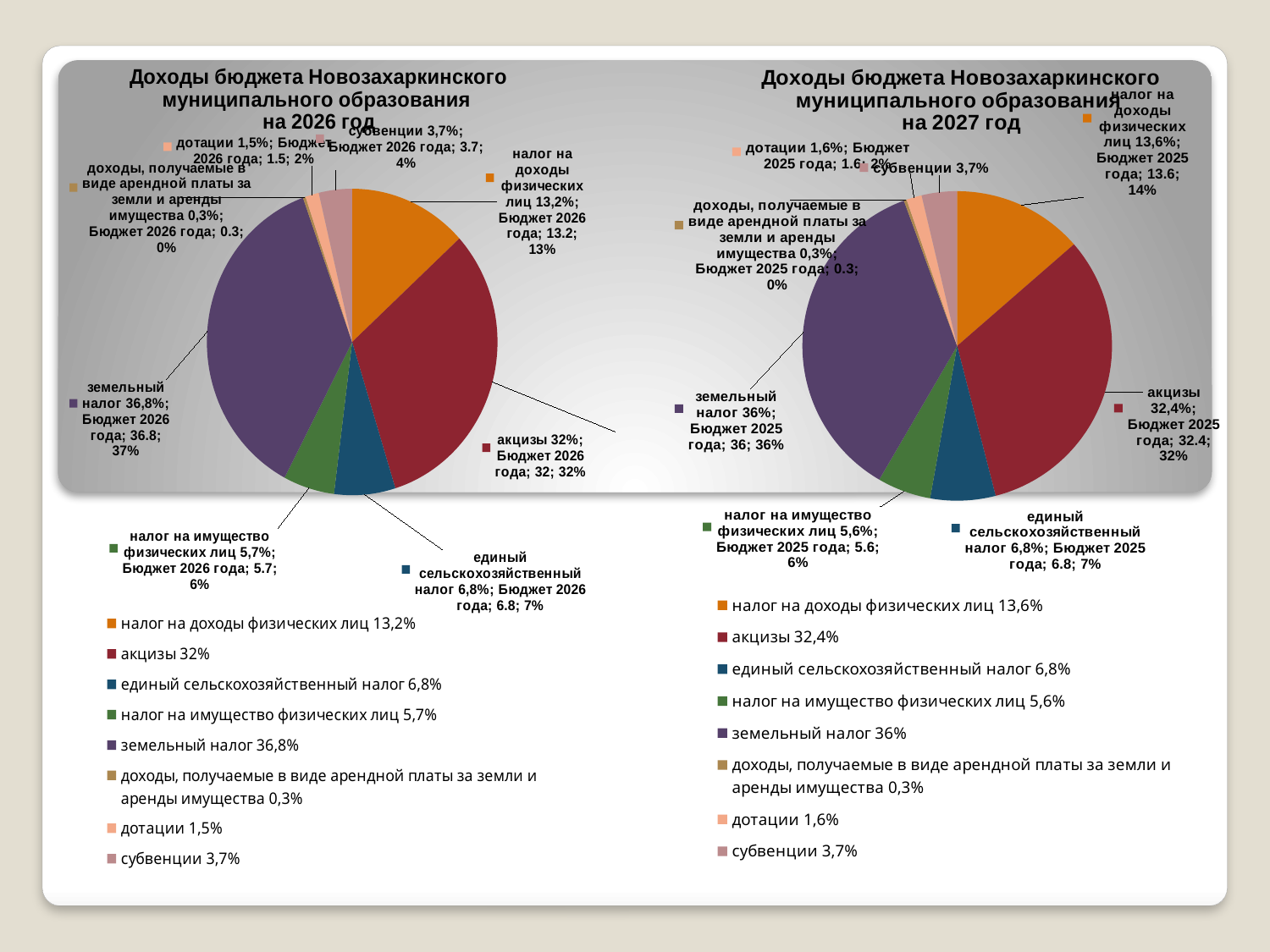
In the 2027 chart (right), what share is shown for дотации? 1,6% How many categories does the legend of the 2027 chart (right) list? 8 In the chart 'Доходы бюджета Новозахаркинского муниципального образования на 2026 год', what share is shown for земельный налог? 36,8% What type of chart is used on the slide for the 2026 budget revenues? Pie chart In the chart 'Доходы бюджета Новозахаркинского муниципального образования на 2027 год', what share is shown for акцизы? 32,4% In the 2026 chart (left), which category has the largest share? земельный налог In the 2026 chart (left), what share is shown for налог на доходы физических лиц? 13,2% In the 2026 chart (left), what share is shown for субвенции? 3,7% In the 2027 chart (right), which category has the smallest share? доходы, получаемые в виде арендной платы за земли и аренды имущества What is the title of the chart on the right side of the slide? Доходы бюджета Новозахаркинского муниципального образования на 2027 год In the 2026 chart (left), what is the difference between the shares of земельный налог and акцизы? 4,8% In the 2027 chart (right), which is larger: the share of единый сельскохозяйственный налог or the share of налог на имущество физических лиц? единый сельскохозяйственный налог